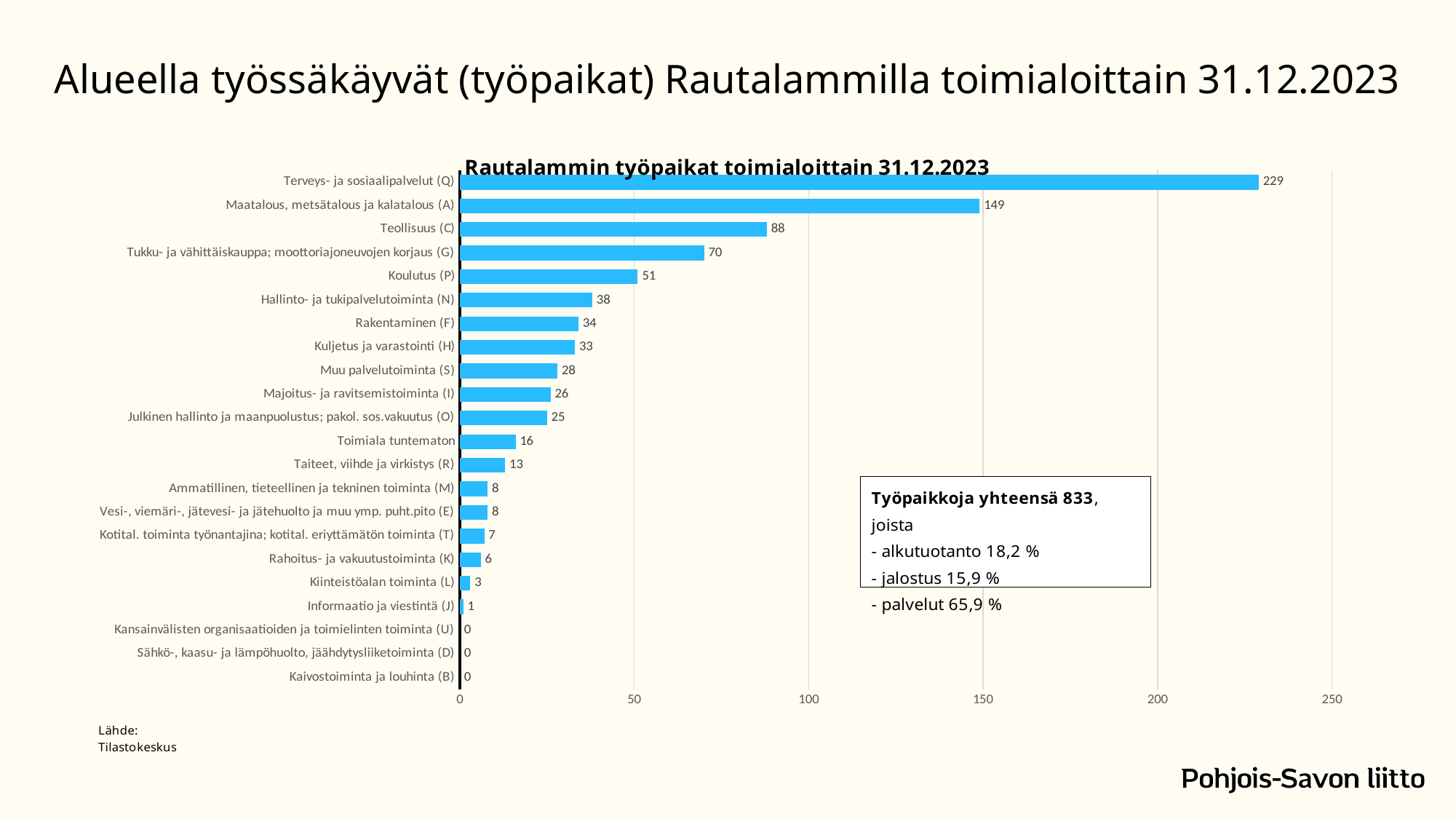
What is the value for Taiteet, viihde ja virkistys (R)? 13 What kind of chart is shown? bar chart Which category has the highest value? Terveys- ja sosiaalipalvelut (Q) What is the title of the chart? Rautalammin työpaikat toimialoittain 31.12.2023 How many categories are shown on the chart? 22 What is the value for Teollisuus (C)? 88 Is the value for Tukku- ja vähittäiskauppa; moottoriajoneuvojen korjaus (G) greater or less than 100? less What is the difference between Terveys- ja sosiaalipalvelut (Q) and Maatalous, metsätalous ja kalatalous (A)? 80 What is the value for Koulutus (P)? 51 What is the difference between Hallinto- ja tukipalvelutoiminta (N) and Muu palvelutoiminta (S)? 10 What is the value for Terveys- ja sosiaalipalvelut (Q)? 229 Which is larger, Rakentaminen (F) or Kuljetus ja varastointi (H)? Rakentaminen (F)